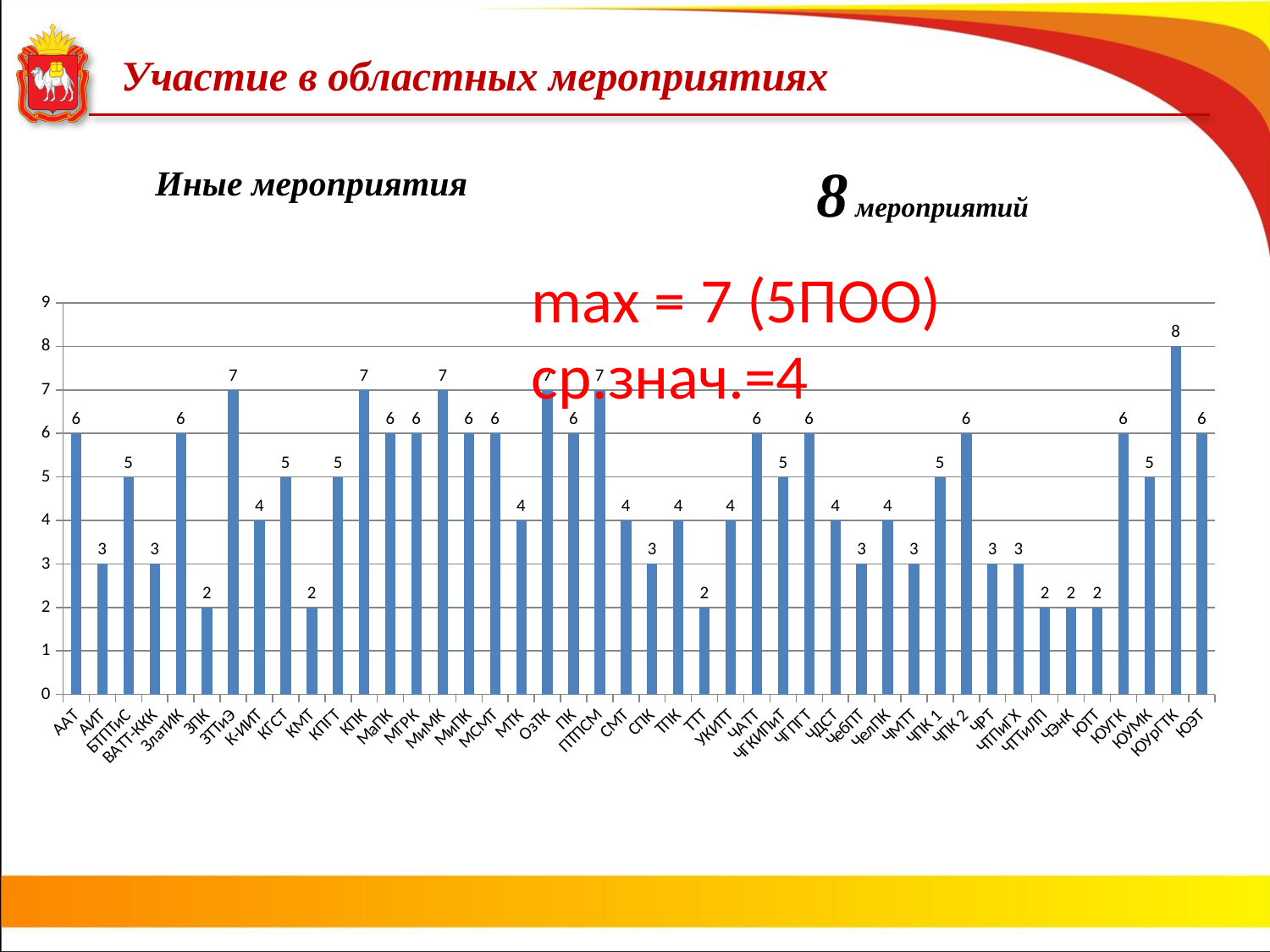
What is the difference between the values for ЮУрГТК and ЮУМК? 3 What is the value for ЗПК? 2 What is the value for ЗТТиЭ? 7 What type of chart is shown on the slide? bar chart Which is larger, the value for АИТ or the value for ЗлатИК? ЗлатИК What is the value for ЮУрГТК? 8 Is the value for МиМК greater or less than 5? greater Which is larger, the value for ТТТ or the value for ЧАТТ? ЧАТТ What is the difference between the values for КПК and КМТ? 5 What is the value for ЧГКИПиТ? 5 Which category has the highest value? ЮУрГТК What is the subtitle shown above the chart on the left? Иные мероприятия